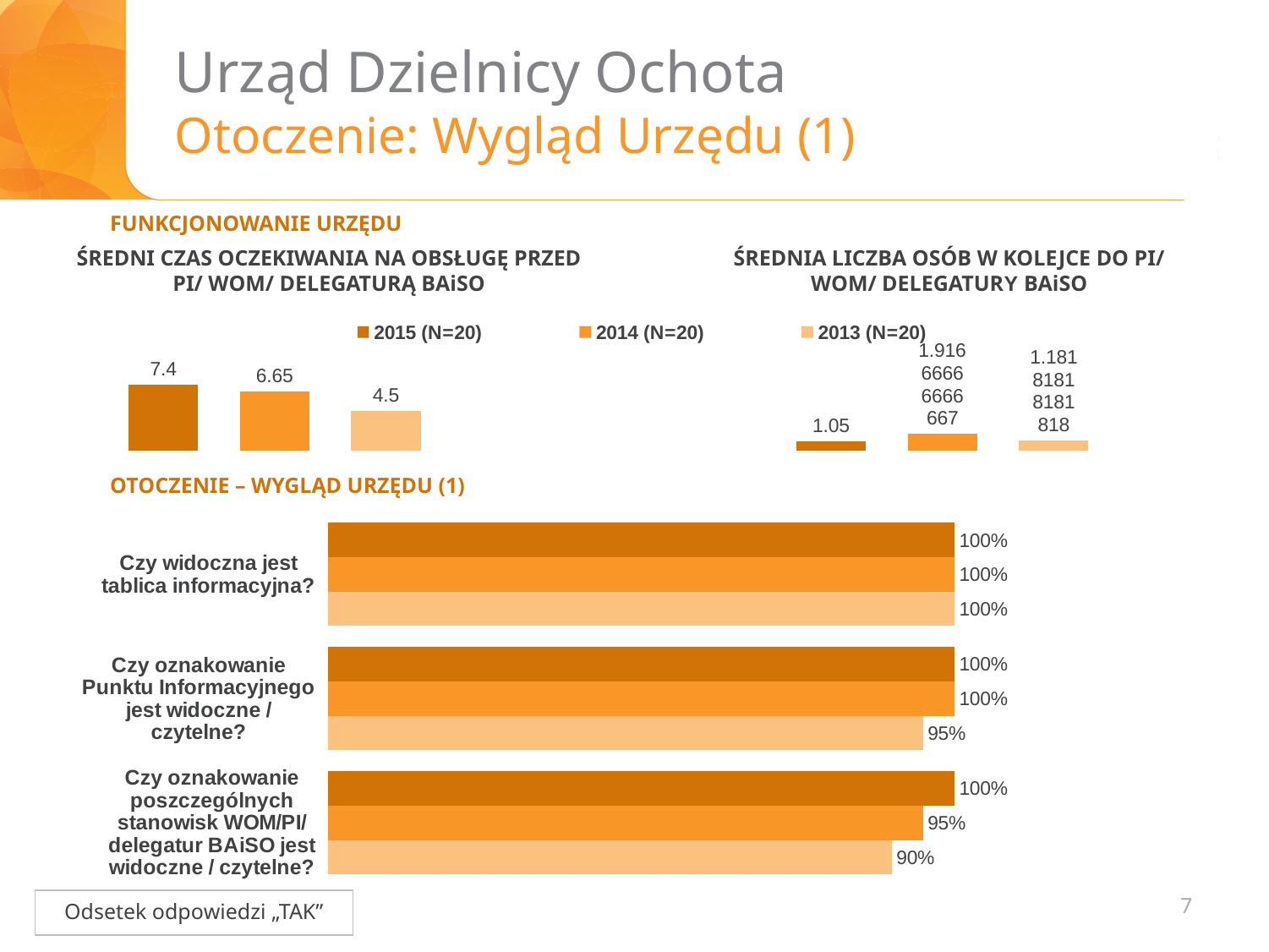
In the chart 'ŚREDNI CZAS OCZEKIWANIA NA OBSŁUGĘ PRZED PI/ WOM/ DELEGATURĄ BAiSO', which year has the lowest value? 2013 (N=20) In the chart 'ŚREDNI CZAS OCZEKIWANIA NA OBSŁUGĘ PRZED PI/ WOM/ DELEGATURĄ BAiSO', what is the difference between the 2015 and 2013 values? 2.9 In the chart 'ŚREDNIA LICZBA OSÓB W KOLEJCE DO PI/ WOM/ DELEGATURY BAiSO', what is the value for 2015 (N=20)? 1.05 In the chart 'OTOCZENIE – WYGLĄD URZĘDU (1)', which is larger for 'Czy oznakowanie poszczególnych stanowisk WOM/PI/ delegatur BAiSO jest widoczne / czytelne?': the 2015 value or the 2014 value? 2015 In the chart 'OTOCZENIE – WYGLĄD URZĘDU (1)', how many question categories are shown? 3 In the chart 'OTOCZENIE – WYGLĄD URZĘDU (1)', what is the 2013 value for 'Czy oznakowanie poszczególnych stanowisk WOM/PI/ delegatur BAiSO jest widoczne / czytelne?'? 90% In the chart 'ŚREDNIA LICZBA OSÓB W KOLEJCE DO PI/ WOM/ DELEGATURY BAiSO', which year has the highest value? 2014 (N=20) In the chart 'ŚREDNI CZAS OCZEKIWANIA NA OBSŁUGĘ PRZED PI/ WOM/ DELEGATURĄ BAiSO', what is the value for 2014 (N=20)? 6.65 In the chart 'OTOCZENIE – WYGLĄD URZĘDU (1)', what is the 2013 value for 'Czy oznakowanie Punktu Informacyjnego jest widoczne / czytelne?'? 95% How many series does the legend above the top charts list? 3 In the chart 'ŚREDNI CZAS OCZEKIWANIA NA OBSŁUGĘ PRZED PI/ WOM/ DELEGATURĄ BAiSO', what is the value for 2015 (N=20)? 7.4 What kind of chart is 'OTOCZENIE – WYGLĄD URZĘDU (1)'? bar chart